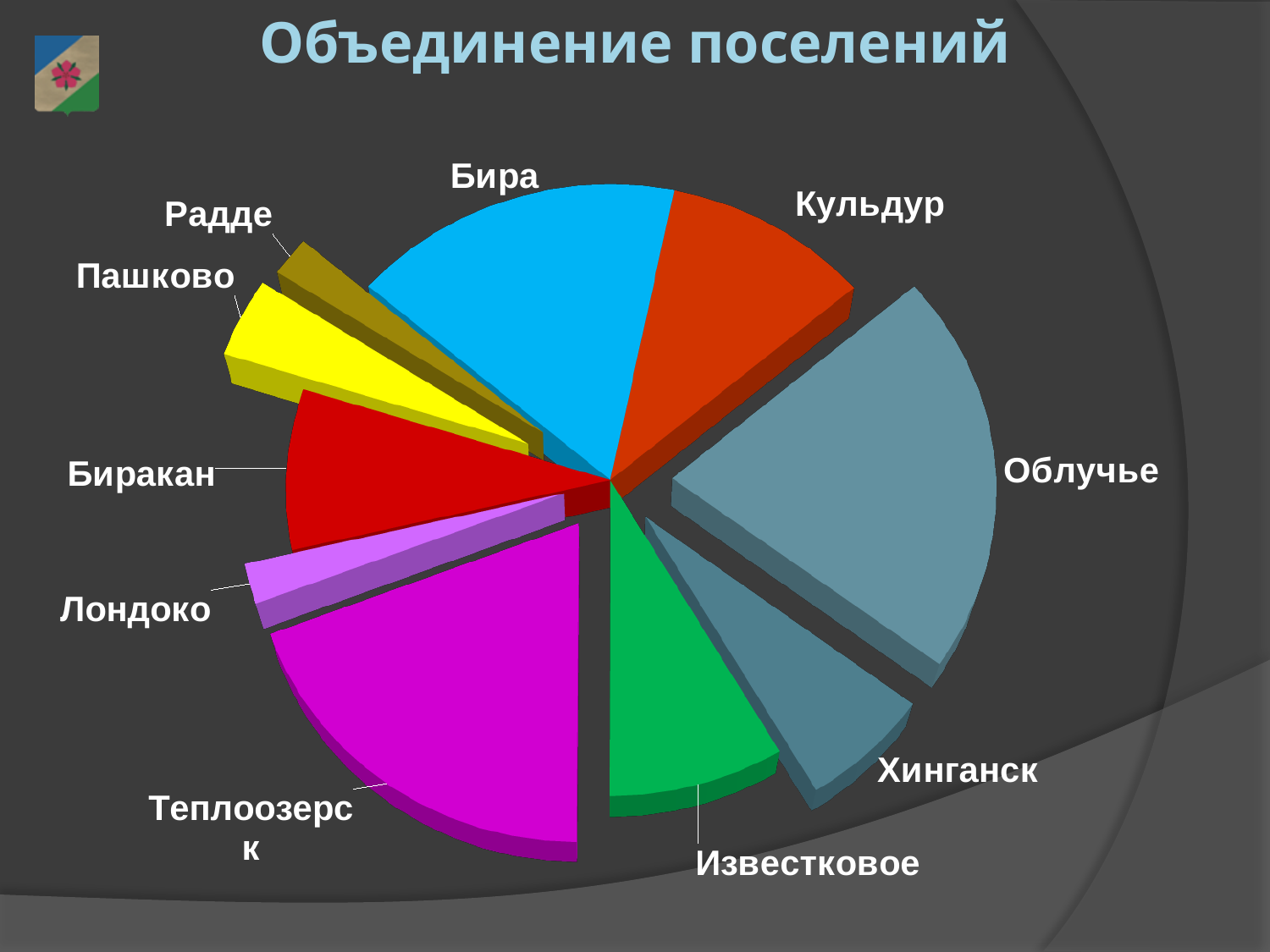
Which slice is larger, Бира or Кульдур? Бира What kind of chart is shown on the slide? pie chart Which slice is larger, Облучье or Лондоко? Облучье Which slice is larger, Облучье or Хинганск? Облучье What colour is the Теплоозерск slice of the pie chart? magenta What is the title of the slide with the pie chart? Объединение поселений How many slices (categories) does the pie chart have? 10